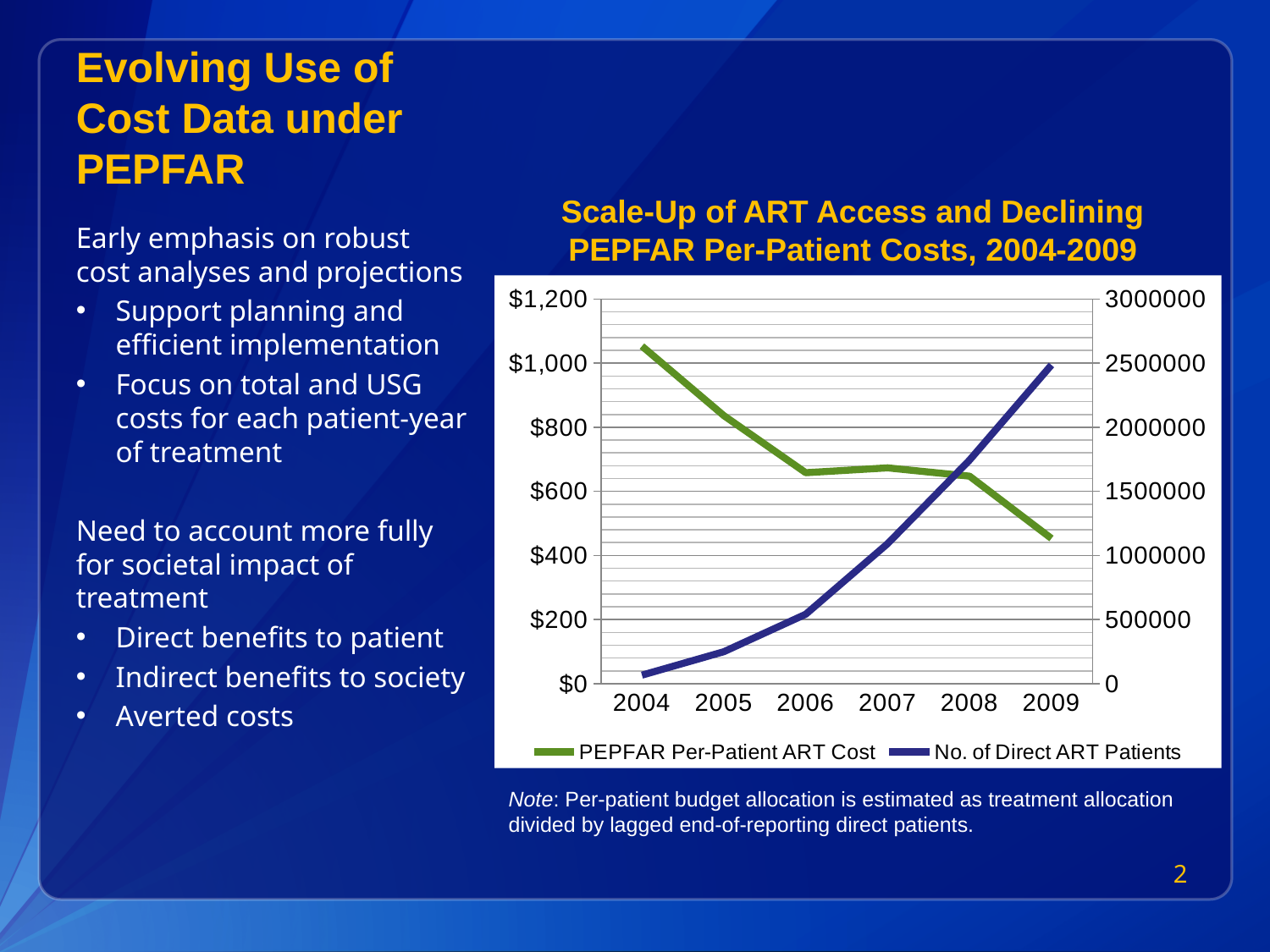
Is the No. of Direct ART Patients in 2008 greater or less than 1500000? greater What is the title of the chart? Scale-Up of ART Access and Declining PEPFAR Per-Patient Costs, 2004-2009 Is the PEPFAR Per-Patient ART Cost in 2009 greater or less than $600? less Does the No. of Direct ART Patients line rise or fall from 2004 to 2009? Rise In which year is the PEPFAR Per-Patient ART Cost highest? 2004 How many series does the chart legend list? 2 In which year is the No. of Direct ART Patients highest? 2009 Is the PEPFAR Per-Patient ART Cost in 2004 greater or less than $1,000? greater Does the PEPFAR Per-Patient ART Cost line generally rise or fall from 2004 to 2009? Fall In which year is the PEPFAR Per-Patient ART Cost lowest? 2009 How many years are plotted along the x axis of the chart? 6 What kind of chart is shown on the slide? Line chart